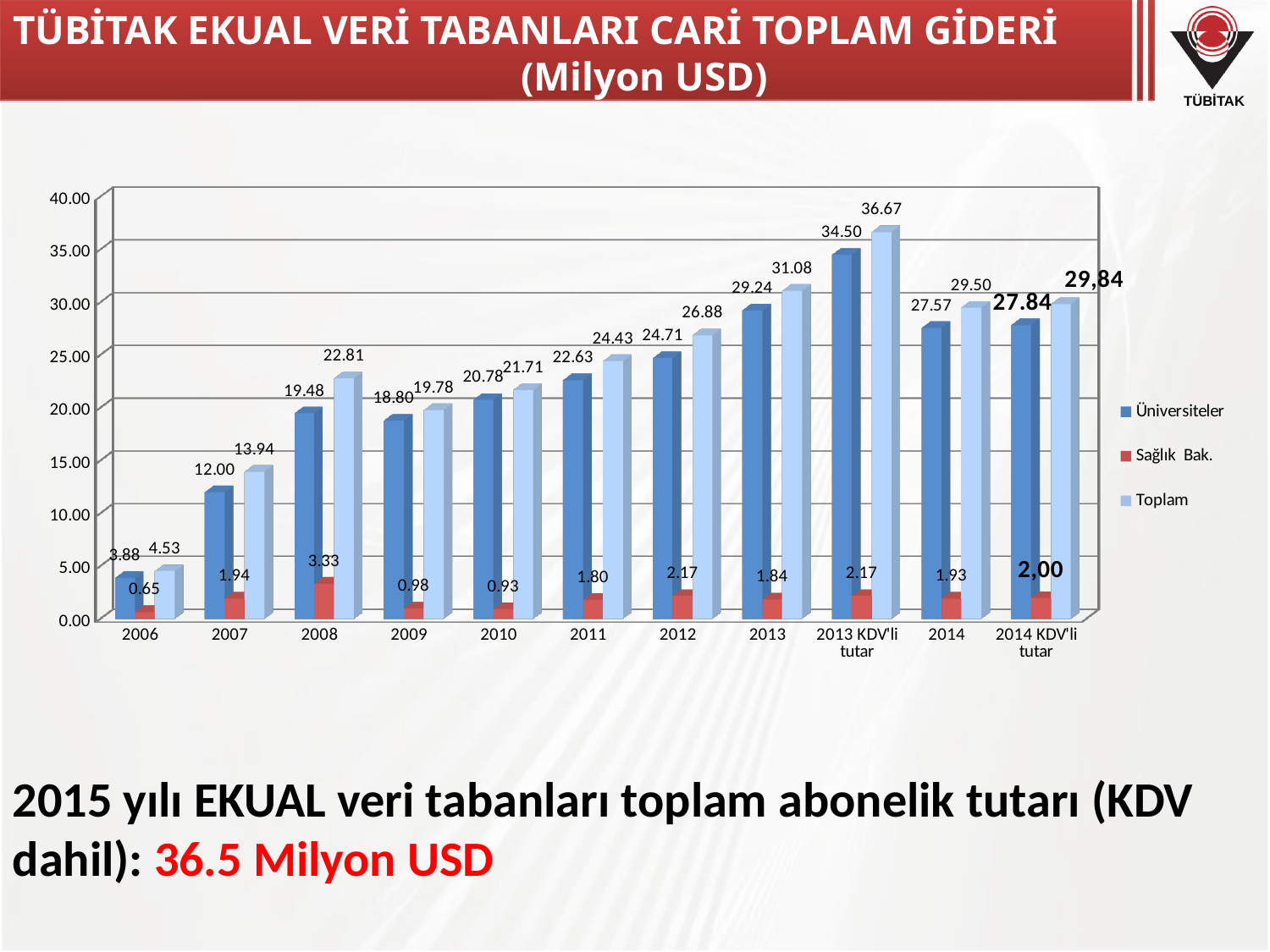
What is the Toplam value for 2013 KDV'li tutar? 36.67 What is the Üniversiteler value for 2010? 20.78 What kind of chart is shown on the slide? bar chart Which is larger, the Üniversiteler value for 2008 or for 2009? 2008 Which category has the highest Toplam value? 2013 KDV'li tutar How many series does the legend list? 3 What is the Sağlık Bak. value for 2008? 3.33 What is the Toplam value for 2014 KDV'li tutar? 29,84 Is the Toplam value for 2011 greater or less than 25.00? less Which category has the lowest Üniversiteler value? 2006 How many categories are shown on the x axis? 11 What is the difference between the Toplam values for 2013 and 2012? 4.20